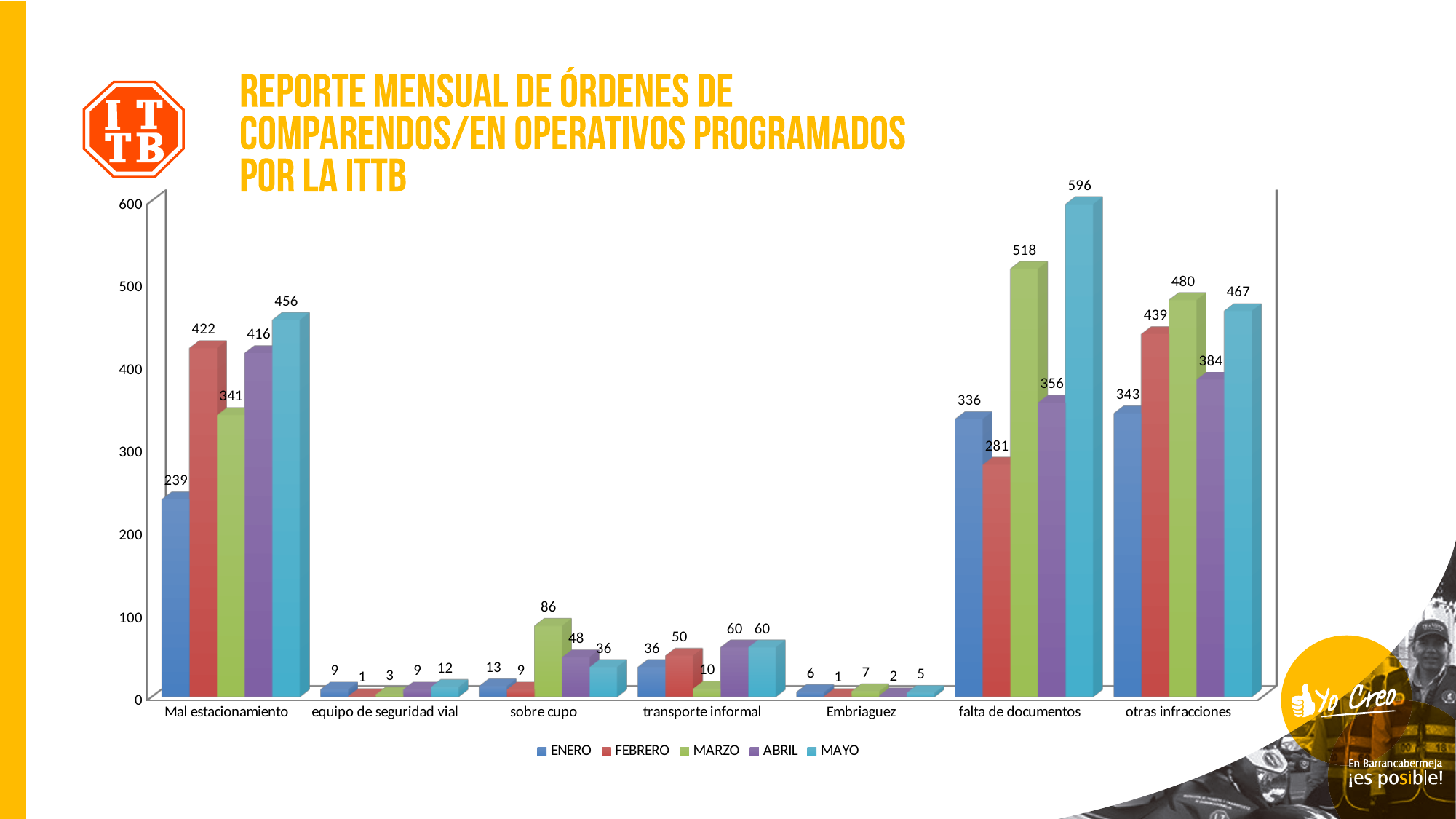
What is the value for MARZO in the 'sobre cupo' category? 86 Which is larger: the FEBRERO value for 'Mal estacionamiento' or the FEBRERO value for 'otras infracciones'? otras infracciones What is the value for MAYO in the 'falta de documentos' category? 596 What is the difference between the MAYO and ENERO values for 'falta de documentos'? 260 Which month has the highest value in the 'otras infracciones' category? MARZO What is the value for ENERO in the 'Mal estacionamiento' category? 239 How many categories are shown on the x axis? 7 Is the MARZO value for 'falta de documentos' greater or less than 500? greater What type of chart is shown on the slide? bar chart Which legend entry is shown in green? MARZO Which month has the lowest value in the 'Embriaguez' category? FEBRERO How many series does the legend list? 5